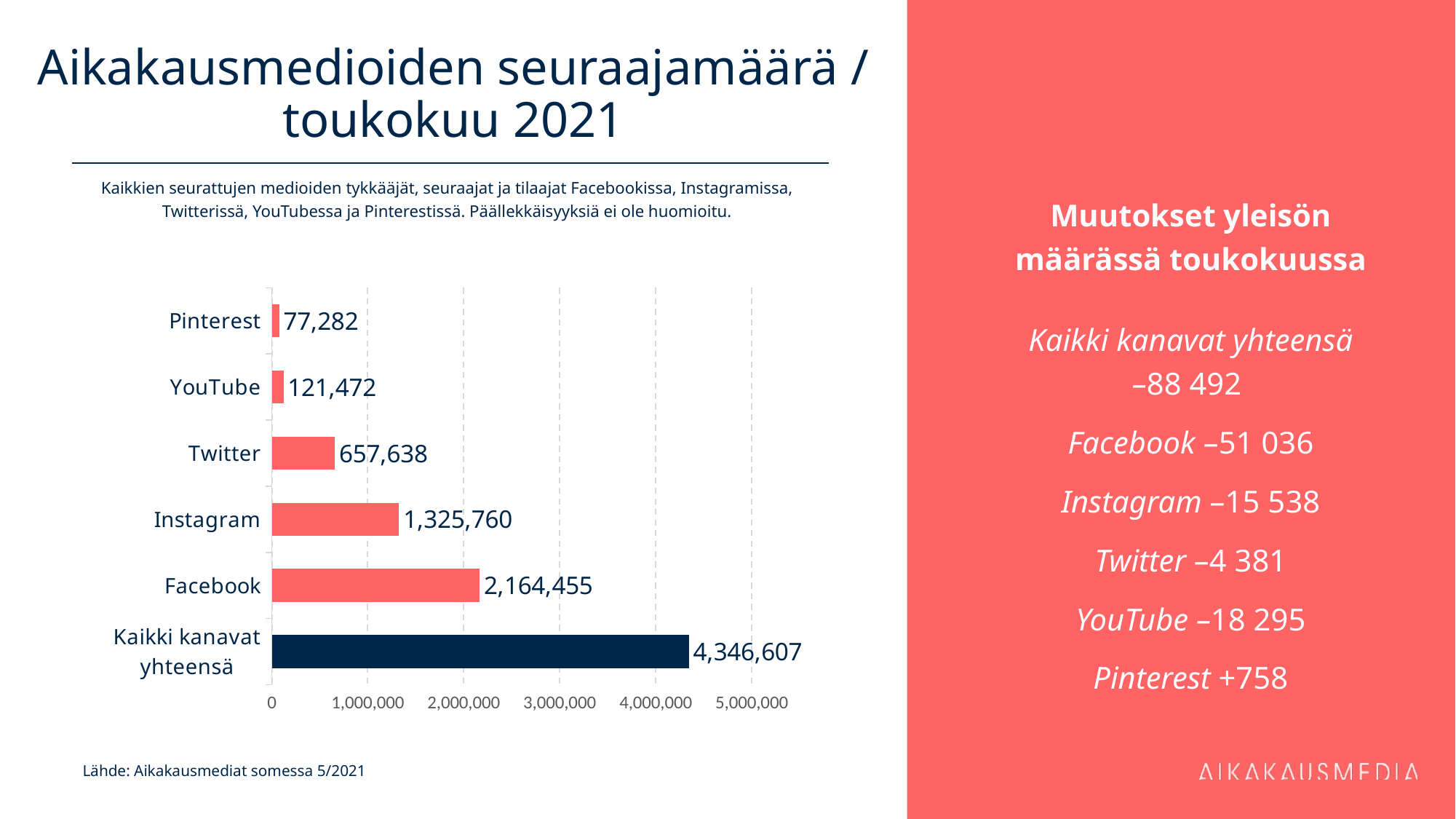
What is the title of the slide containing the chart? Aikakausmedioiden seuraajamäärä / toukokuu 2021 What is the value shown for the bar labelled 'Kaikki kanavat yhteensä'? 4,346,607 How many bars are shown in the chart? 6 Which has a larger value, Twitter or YouTube? Twitter What type of chart is shown on the slide? Bar chart What is the value shown for Instagram? 1,325,760 Excluding the total bar 'Kaikki kanavat yhteensä', which individual channel has the highest value? Facebook What is the difference between the values for Facebook and Instagram? 838,695 What is the value shown for Pinterest? 77,282 What is the value shown for Facebook? 2,164,455 Which category has the lowest value in the chart? Pinterest What is the difference between the values for Twitter and YouTube? 536,166